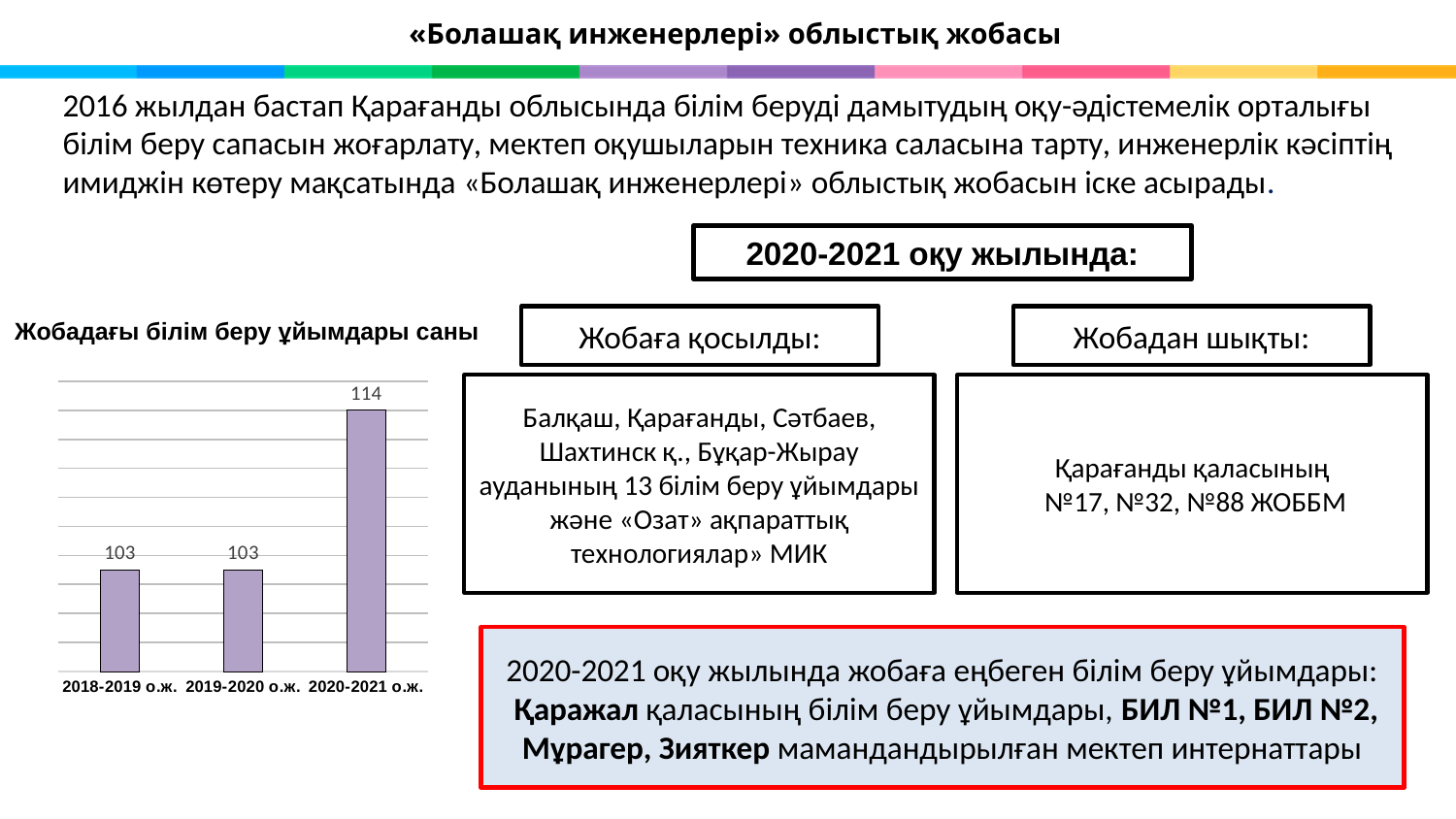
What type of chart is shown on the slide? bar chart How many categories are shown on the x axis of the chart? 3 What is the value for 2018-2019 о.ж.? 103 Which is larger, the value for 2020-2021 о.ж. or the value for 2018-2019 о.ж.? 2020-2021 о.ж. What is the title of the chart? Жобадағы білім беру ұйымдары саны What is the value for 2019-2020 о.ж.? 103 Do the values rise or fall from 2019-2020 о.ж. to 2020-2021 о.ж.? rise Which category has the highest value? 2020-2021 о.ж. What is the value for 2020-2021 о.ж.? 114 What is the difference between the values for 2020-2021 о.ж. and 2019-2020 о.ж.? 11 Are the values for 2018-2019 о.ж. and 2019-2020 о.ж. equal? yes